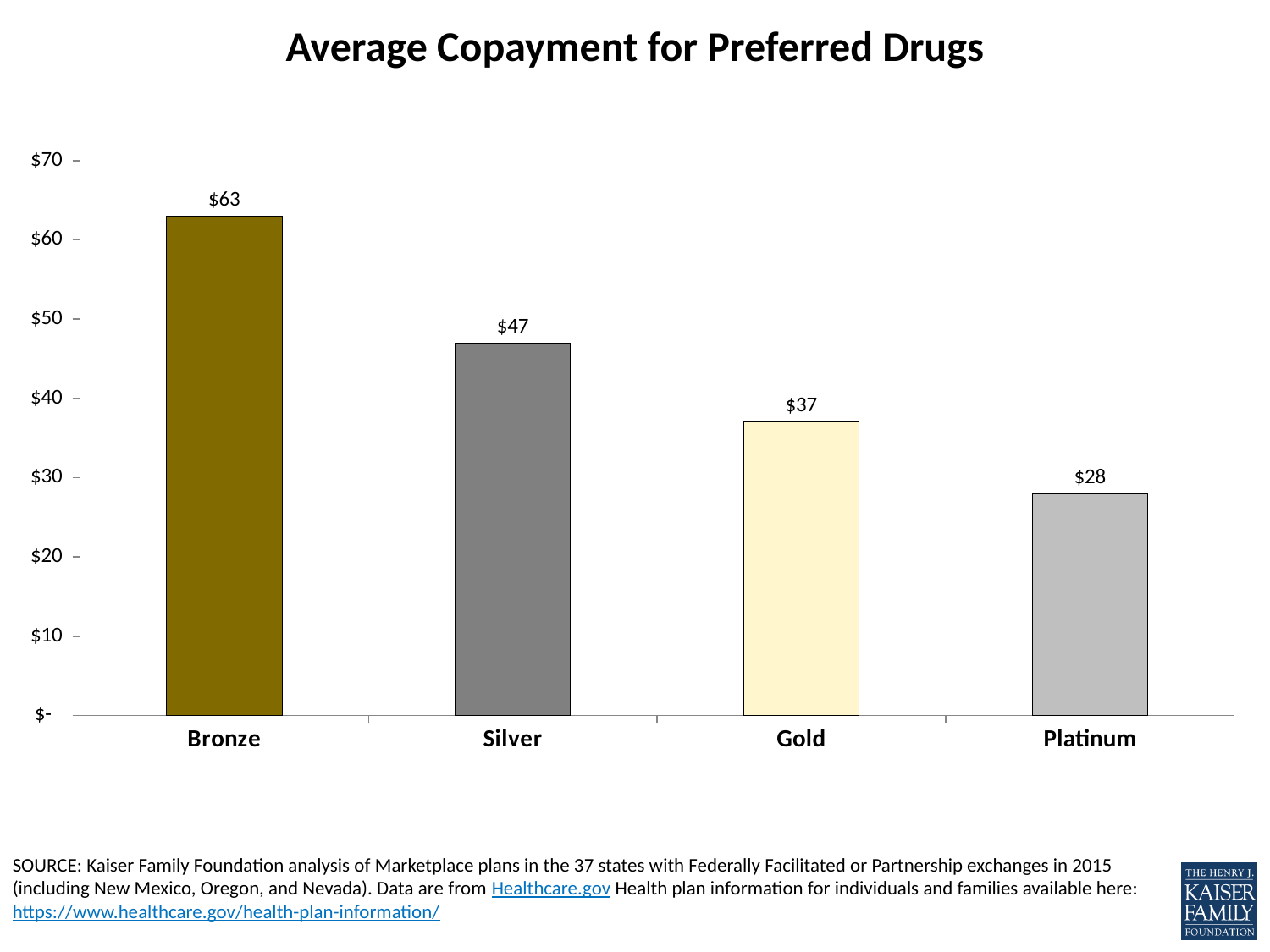
How many plan types are shown in the chart? 4 What is the average copayment for preferred drugs for Bronze plans? $63 What is the difference between the average copayment for Bronze and Platinum plans? $35 What is the difference between the average copayment for Silver and Gold plans? $10 What is the average copayment for preferred drugs for Platinum plans? $28 Which has a higher average copayment for preferred drugs, Silver or Gold? Silver Which plan type has the highest average copayment for preferred drugs? Bronze What kind of chart is shown on the slide? Bar chart Which plan type has the lowest average copayment for preferred drugs? Platinum Do the average copayments rise or fall moving from Bronze to Platinum along the x axis? Fall What is the average copayment for preferred drugs for Gold plans? $37 What is the average copayment for preferred drugs for Silver plans? $47